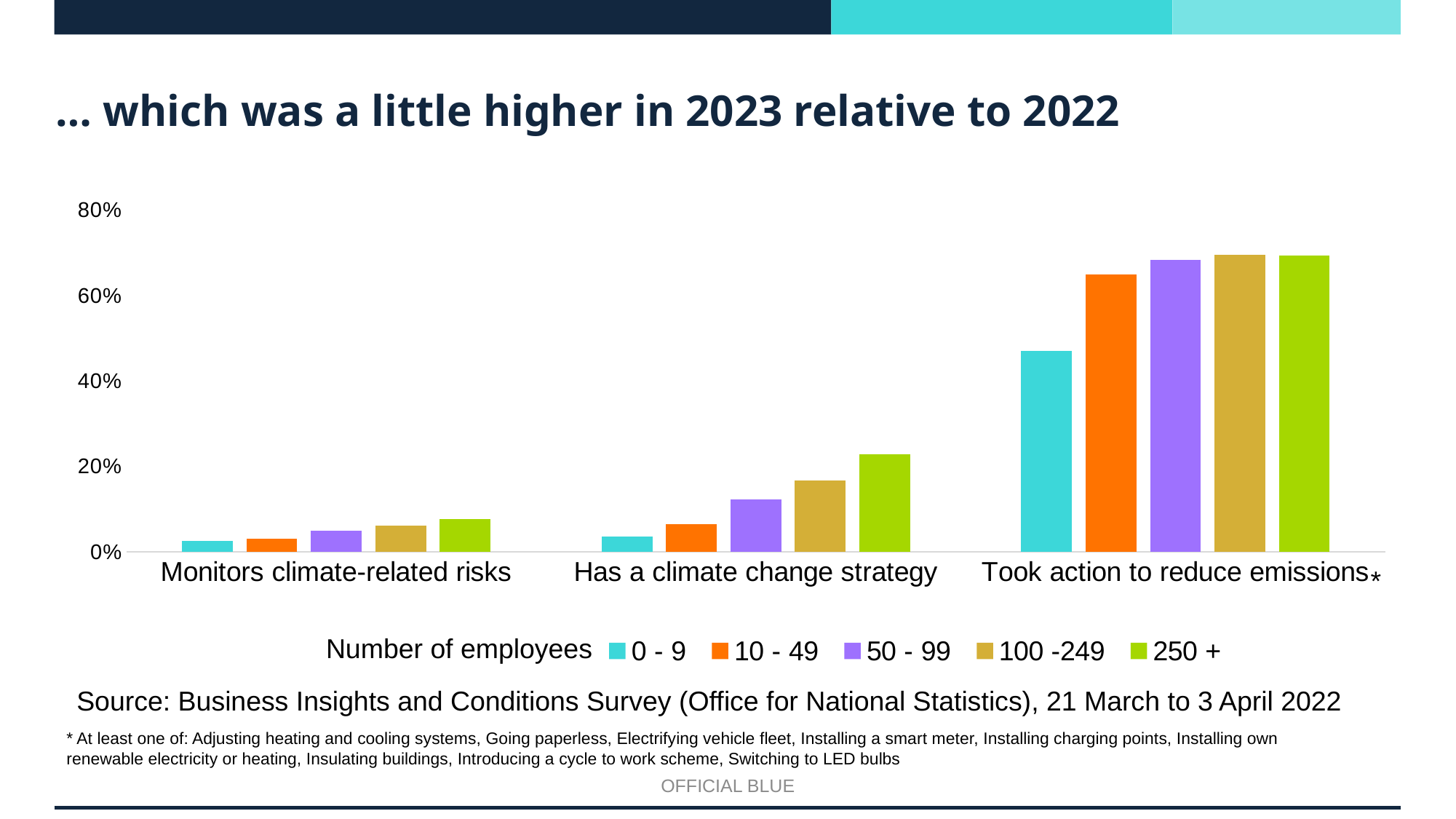
Is the value for the 250 + employees series in the 'Has a climate change strategy' category greater or less than 40%? less What kind of chart is shown on the slide? bar chart Within the 'Took action to reduce emissions' category, which employee-size series has the lowest value? 0 - 9 How many categories are shown along the x axis of the chart? 3 What is the title of the legend on the chart? Number of employees Within the 'Has a climate change strategy' category, which employee-size series has the highest value? 250 + Is the value for the 0 - 9 employees series in the 'Monitors climate-related risks' category greater or less than 20%? less How many series does the chart's legend list? 5 Which category has the highest values across all employee-size series? Took action to reduce emissions In the 'Has a climate change strategy' category, is the value for 10 - 49 employees larger or smaller than the value for 100 -249 employees? smaller Is the value for the 250 + employees series in the 'Took action to reduce emissions' category greater or less than 60%? greater